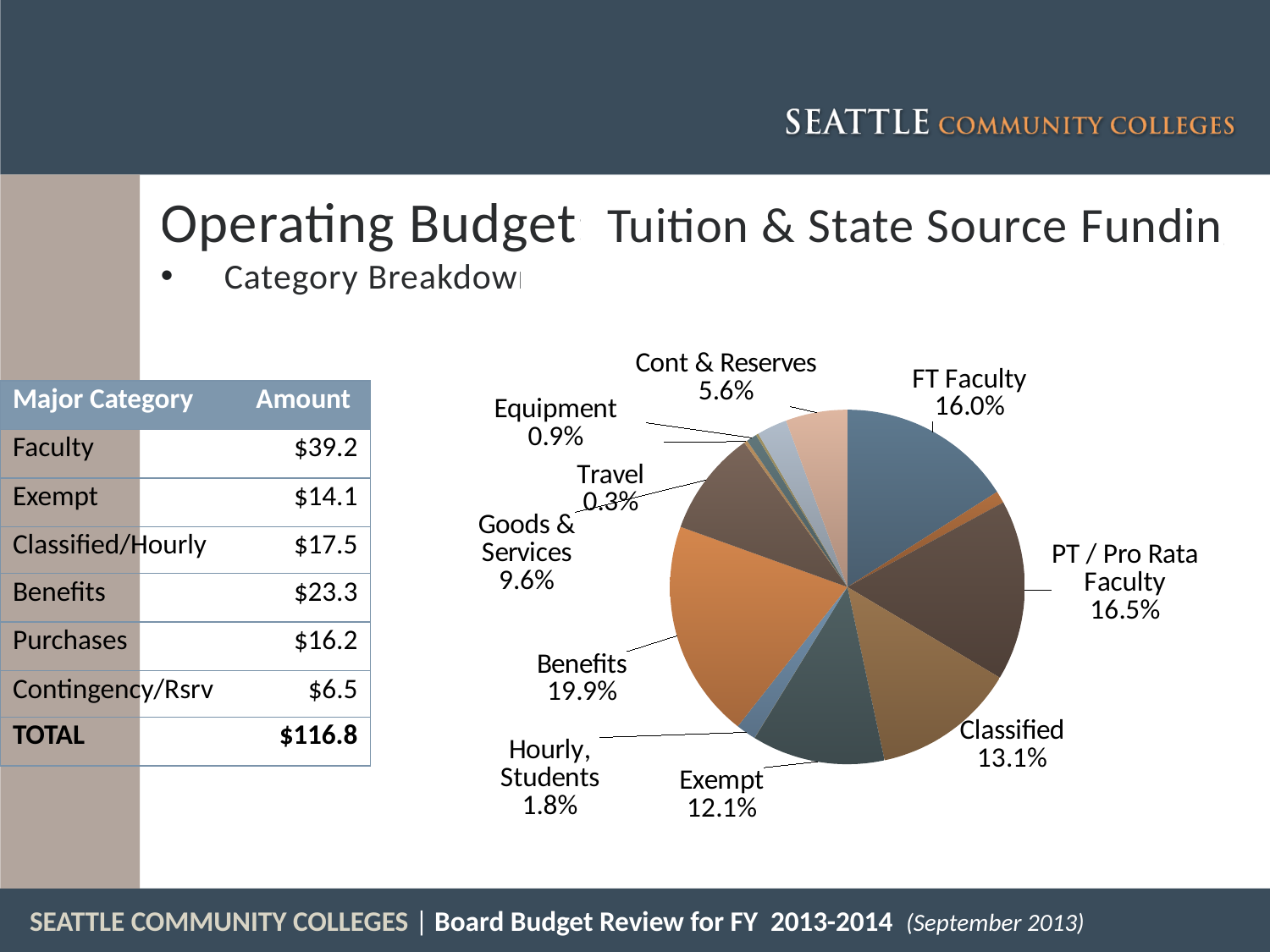
What type of chart is shown on the slide? pie chart What percentage is shown for Cont & Reserves? 5.6% What is the difference in percentage points between PT / Pro Rata Faculty and FT Faculty? 0.5 What percentage is shown for Travel? 0.3% What is the difference in percentage points between Benefits and Exempt? 7.8 What share of the pie does Benefits represent? 19.9% Which is larger, the share for Classified or the share for Goods & Services? Classified What percentage is shown for PT / Pro Rata Faculty? 16.5% What percentage is shown for Hourly, Students? 1.8% Which category has the largest slice of the pie? Benefits